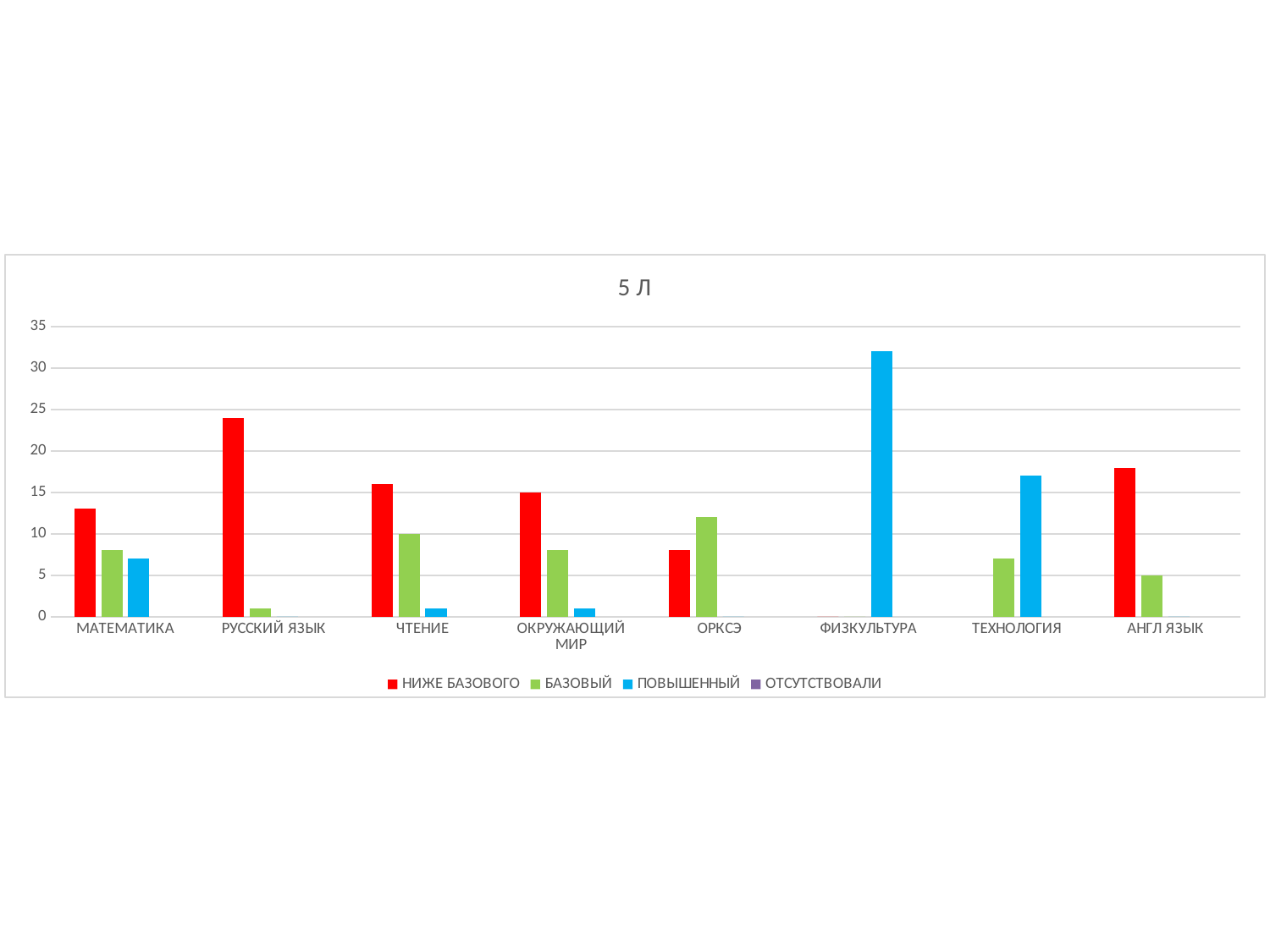
Which subject has the highest НИЖЕ БАЗОВОГО value? РУССКИЙ ЯЗЫК Which is larger for ТЕХНОЛОГИЯ: the БАЗОВЫЙ value or the ПОВЫШЕННЫЙ value? ПОВЫШЕННЫЙ Which is larger for ОРКСЭ: the НИЖЕ БАЗОВОГО value or the БАЗОВЫЙ value? БАЗОВЫЙ Is the НИЖЕ БАЗОВОГО value for РУССКИЙ ЯЗЫК greater or less than 20? greater Which subject has the highest ПОВЫШЕННЫЙ value? ФИЗКУЛЬТУРА What is the title of the chart? 5 Л How many subject categories are shown on the x axis? 8 Is the ПОВЫШЕННЫЙ value for ФИЗКУЛЬТУРА greater or less than 30? greater What type of chart is shown on the slide? bar chart Is the БАЗОВЫЙ value for МАТЕМАТИКА greater or less than 10? less Which colour represents the ПОВЫШЕННЫЙ series? blue How many series does the legend list? 4